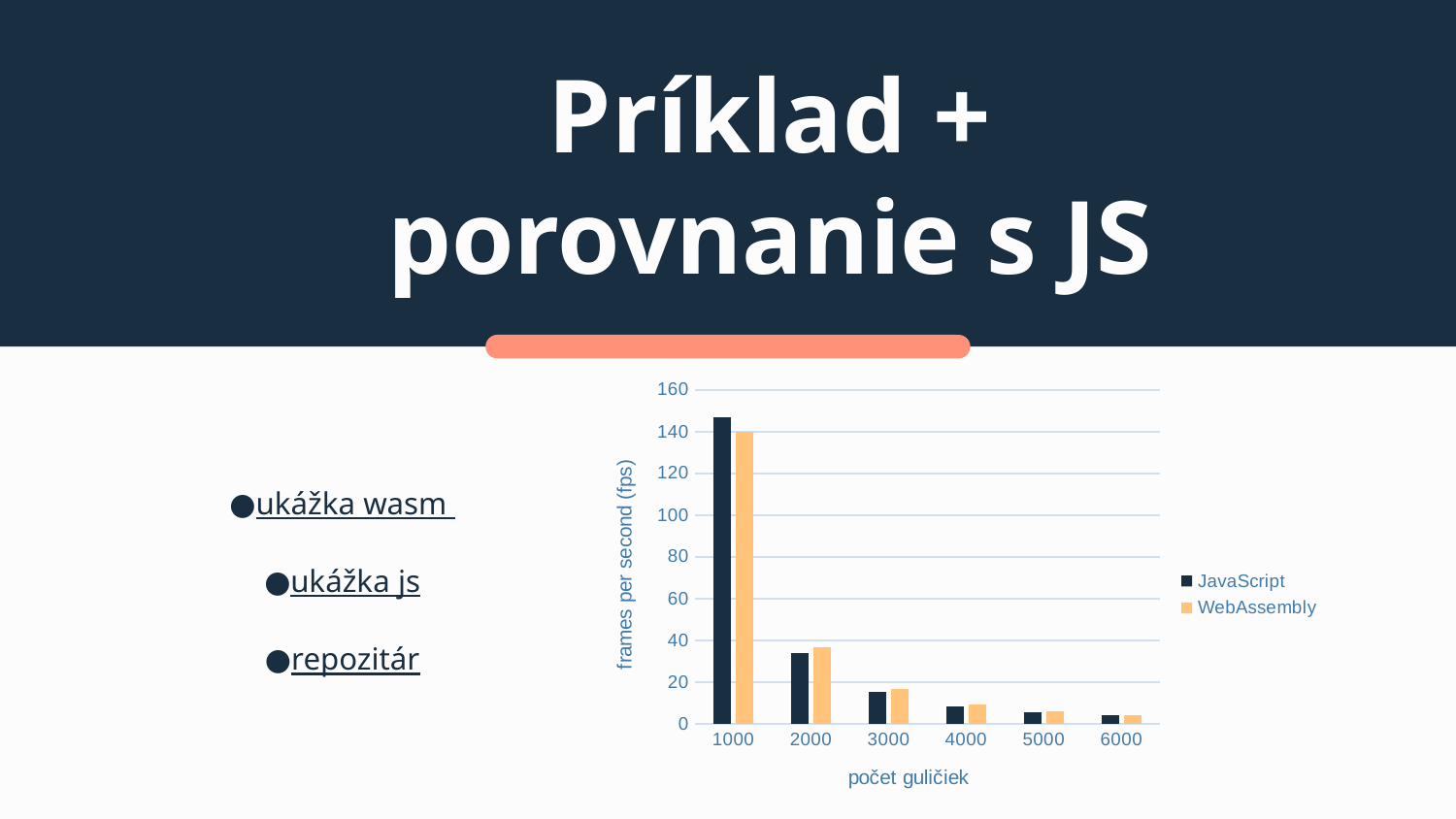
Do the values rise or fall as the number of balls (počet guličiek) increases along the x axis? fall Which category has the lowest WebAssembly value? 6000 Is the JavaScript value for 2000 greater or less than 40? less What is the label of the y axis? frames per second (fps) What kind of chart is shown on the slide? bar chart Is the JavaScript value for 1000 greater or less than 120? greater At 1000, which series has the larger value, JavaScript or WebAssembly? JavaScript Is the WebAssembly value for 1000 greater or less than 160? less Which category has the highest JavaScript value? 1000 How many categories are shown on the x axis? 6 How many series does the legend list? 2